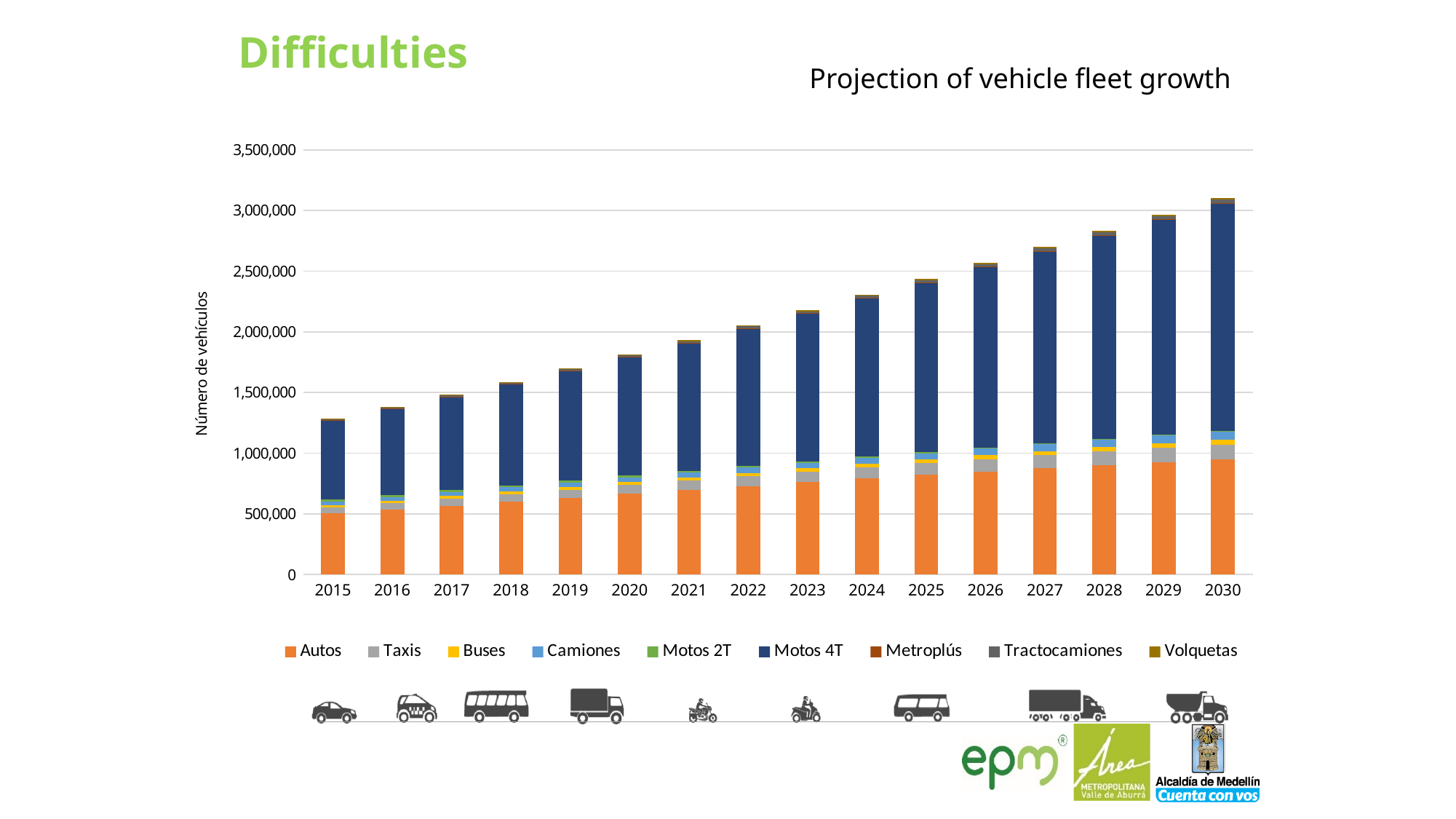
What kind of chart is shown on the slide? Stacked bar chart Which year has the highest total number of vehicles? 2030 Do the total bar heights rise or fall from 2015 to 2030? Rise Is the total for 2030 greater or less than 3,000,000? greater What is the label on the vertical axis? Número de vehículos Is the total for 2020 greater or less than 2,000,000? less How many years are shown along the x axis? 16 Which is larger, the total for 2025 or the total for 2018? 2025 Is the total for 2015 greater or less than 1,500,000? less What is the title of the chart? Projection of vehicle fleet growth How many series does the legend list? 9 Which year has the lowest total number of vehicles? 2015